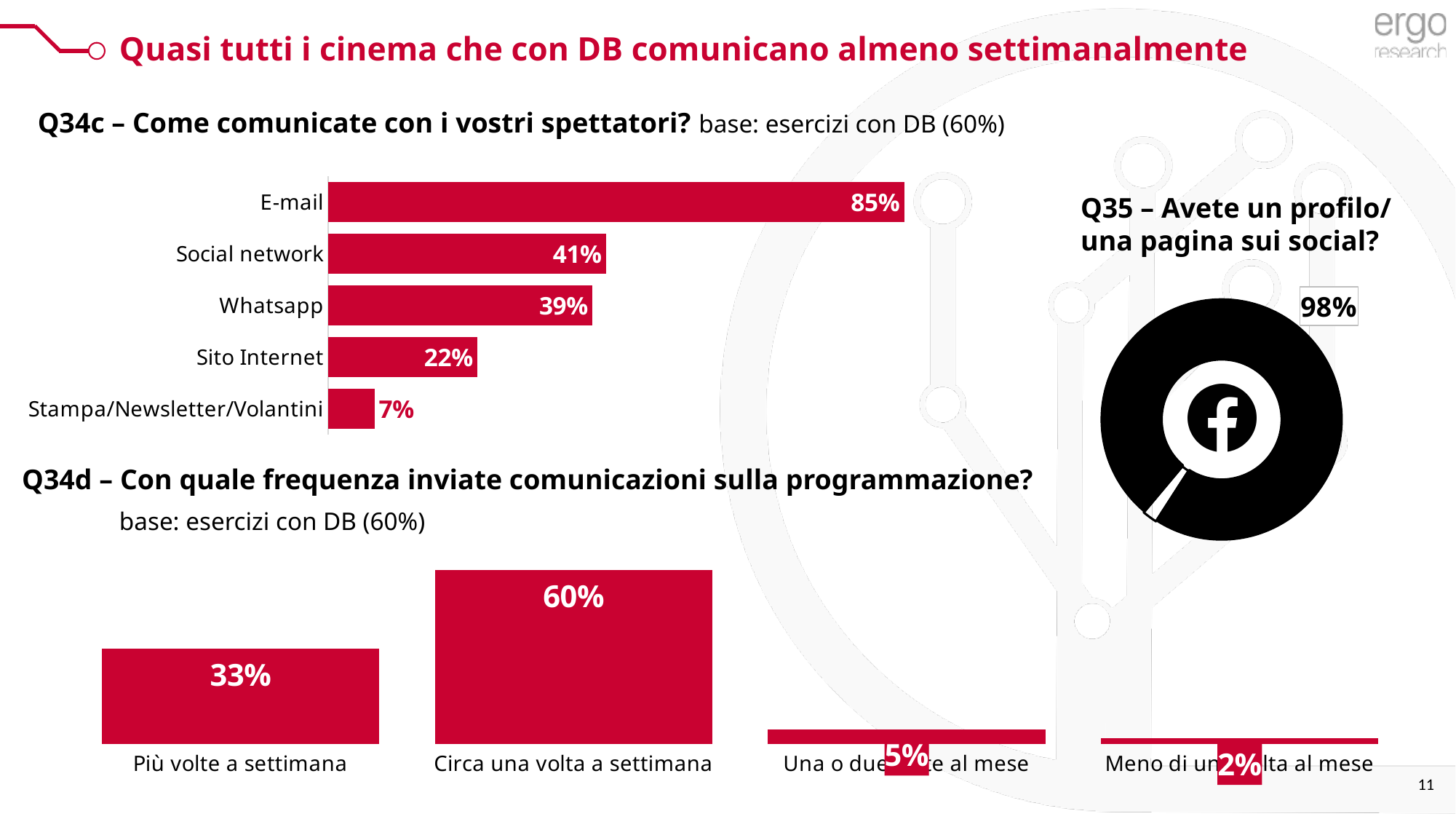
In the Q34d chart, which is larger: Più volte a settimana or Circa una volta a settimana? Circa una volta a settimana What kind of chart is the Q34c chart? Bar chart In the Q34c chart, which category has the highest value? E-mail In the Q34c chart, which category has the lowest value? Stampa/Newsletter/Volantini In the Q34d chart, what is the value for Più volte a settimana? 33% In the Q34c chart, what is the value for Stampa/Newsletter/Volantini? 7% In the Q34c chart, what is the value for Whatsapp? 39% In the Q34c chart, what is the difference between the values for Social network and Sito Internet? 19% In the Q34c chart (Come comunicate con i vostri spettatori?), what is the value for E-mail? 85% In the Q34d chart (Con quale frequenza inviate comunicazioni sulla programmazione?), what is the value for Circa una volta a settimana? 60% In the Q34d chart, how many categories are shown? 4 In the Q34c chart, how many categories are shown? 5